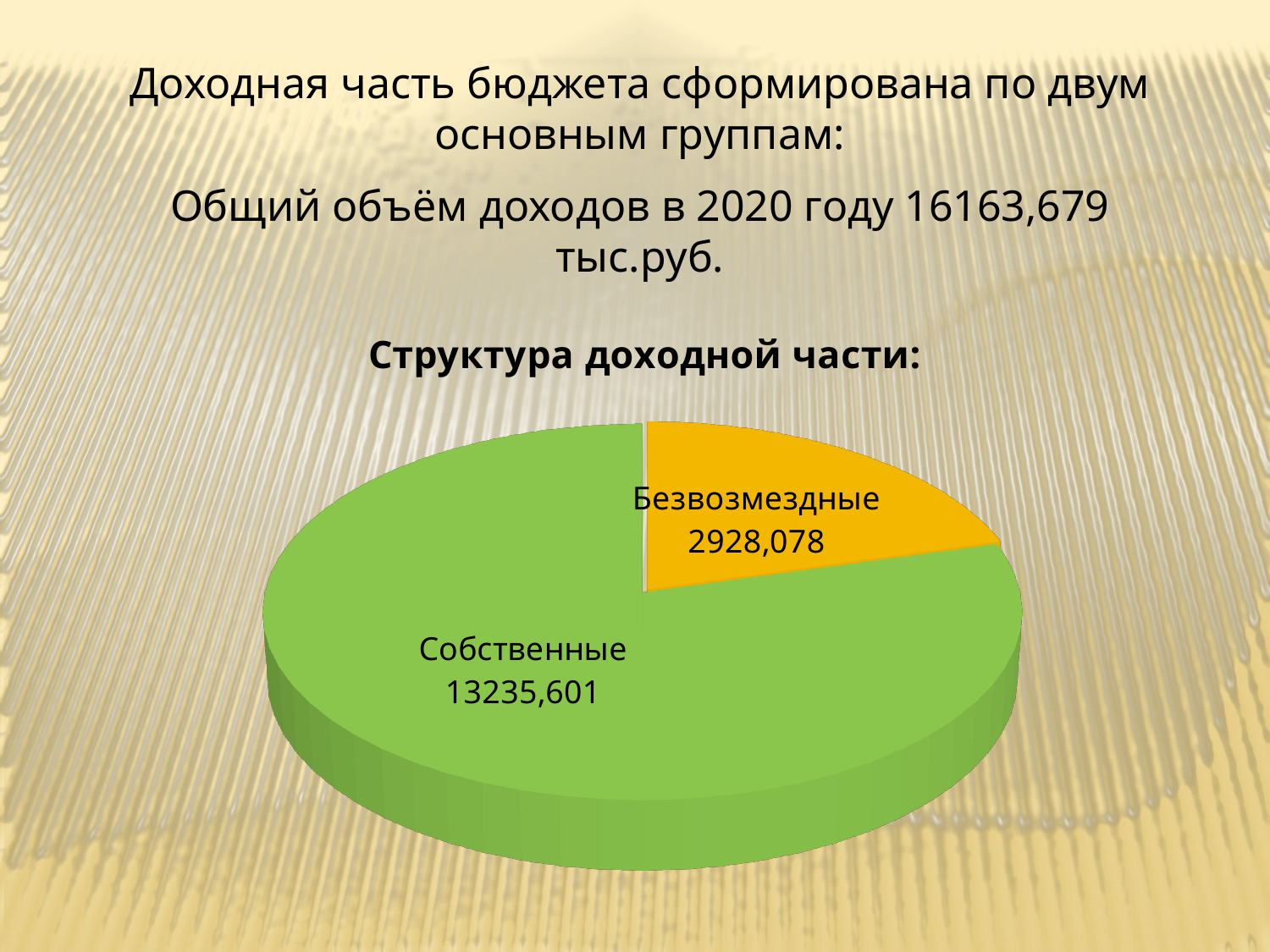
What is the title of the chart? Структура доходной части: How many categories are shown in the pie chart? 2 What is the value for Собственные in the pie chart? 13235,601 What is the total of the two slices in the pie chart? 16163,679 Which is larger, Собственные or Безвозмездные? Собственные Which category has the largest slice in the pie chart? Собственные Which category has the smallest slice in the pie chart? Безвозмездные What type of chart is shown on the slide? Pie chart What is the difference between the values for Собственные and Безвозмездные? 10307,523 What share of the pie does Собственные represent? 81.9% What colour is the Безвозмездные slice? Orange What is the value for Безвозмездные in the pie chart? 2928,078